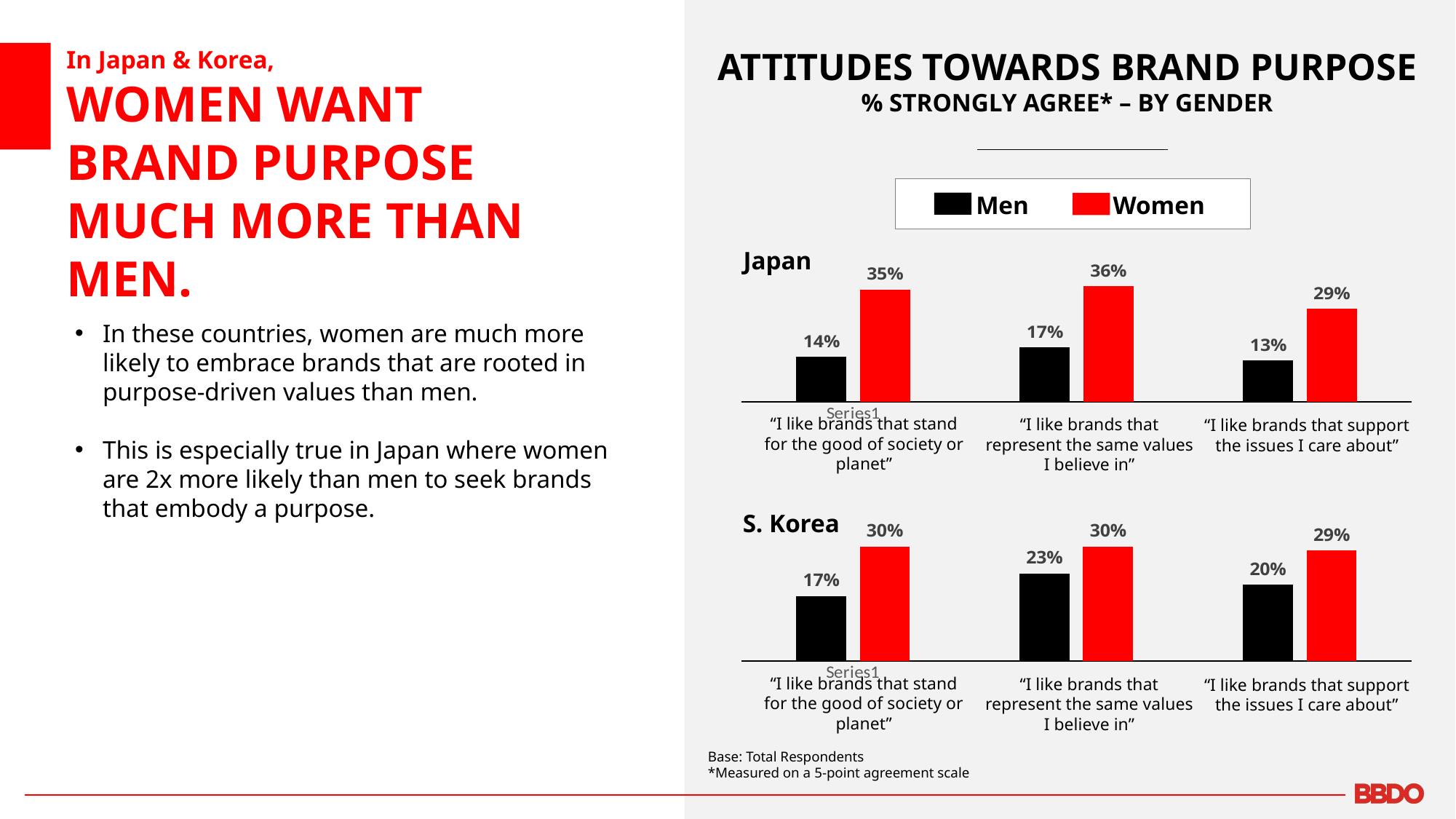
In the Japan chart, what percentage of men strongly agree with "I like brands that support the issues I care about"? 13% In the Japan chart, what percentage of women strongly agree with "I like brands that stand for the good of society or planet"? 35% How many series does the legend list for the charts? 2 In the Japan chart, which is larger for "I like brands that support the issues I care about": men or women? Women In the S. Korea chart, what is the difference between women and men for "I like brands that stand for the good of society or planet"? 13% In the S. Korea chart, what percentage of men strongly agree with "I like brands that represent the same values I believe in"? 23% What type of chart is used for the Japan data? Bar chart In the S. Korea chart, what percentage of women strongly agree with "I like brands that support the issues I care about"? 29% In the S. Korea chart, which statement has the lowest value for men? "I like brands that stand for the good of society or planet" In the Japan chart, which statement has the highest value for women? "I like brands that represent the same values I believe in" How many statements (categories) are shown in the S. Korea chart? 3 In the Japan chart, what is the difference between women and men for "I like brands that represent the same values I believe in"? 19%